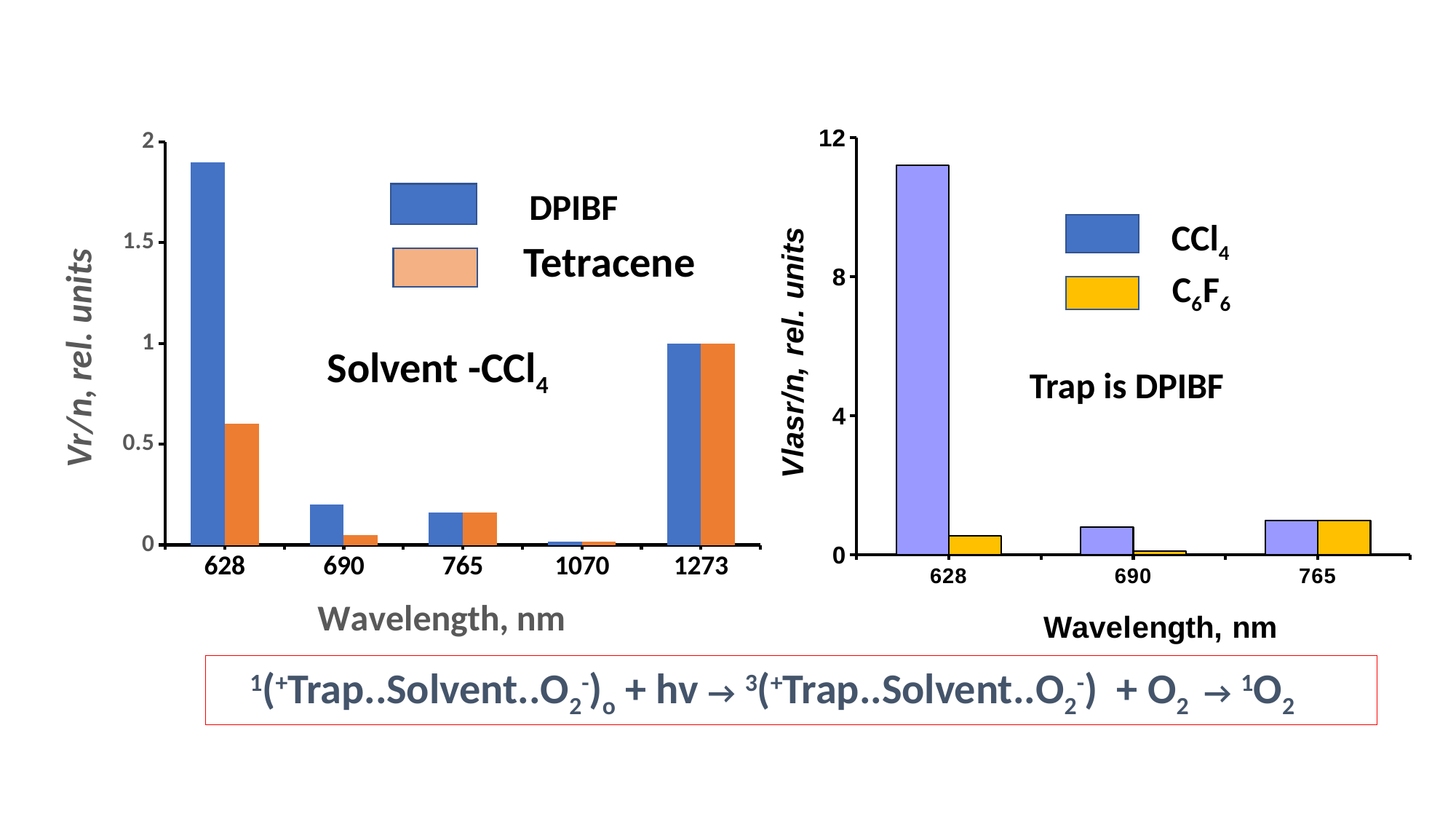
In the left chart (Solvent -CCl4), is the DPIBF value at 628 nm greater or less than 1.5? greater In the left chart (Solvent -CCl4), at which wavelength is the DPIBF value highest? 628 In the right chart (Trap is DPIBF), is the CCl4 value at 628 nm greater or less than 8? greater In the right chart (Trap is DPIBF), at which wavelength is the CCl4 value highest? 628 In the left chart (Solvent -CCl4), at 628 nm, which series has the larger value, DPIBF or Tetracene? DPIBF In the left chart (Solvent -CCl4), is the Tetracene value at 628 nm greater or less than 1? less In the left chart (Solvent -CCl4), how many series does the legend list? 2 In the right chart (Trap is DPIBF), how many series does the legend list? 2 In the right chart (Trap is DPIBF), which series is shown in yellow? C6F6 In the left chart (Solvent -CCl4), how many wavelength categories are shown on the x axis? 5 In the right chart (Trap is DPIBF), how many wavelength categories are shown on the x axis? 3 What kind of chart is the left chart labelled "Solvent -CCl4"? bar chart